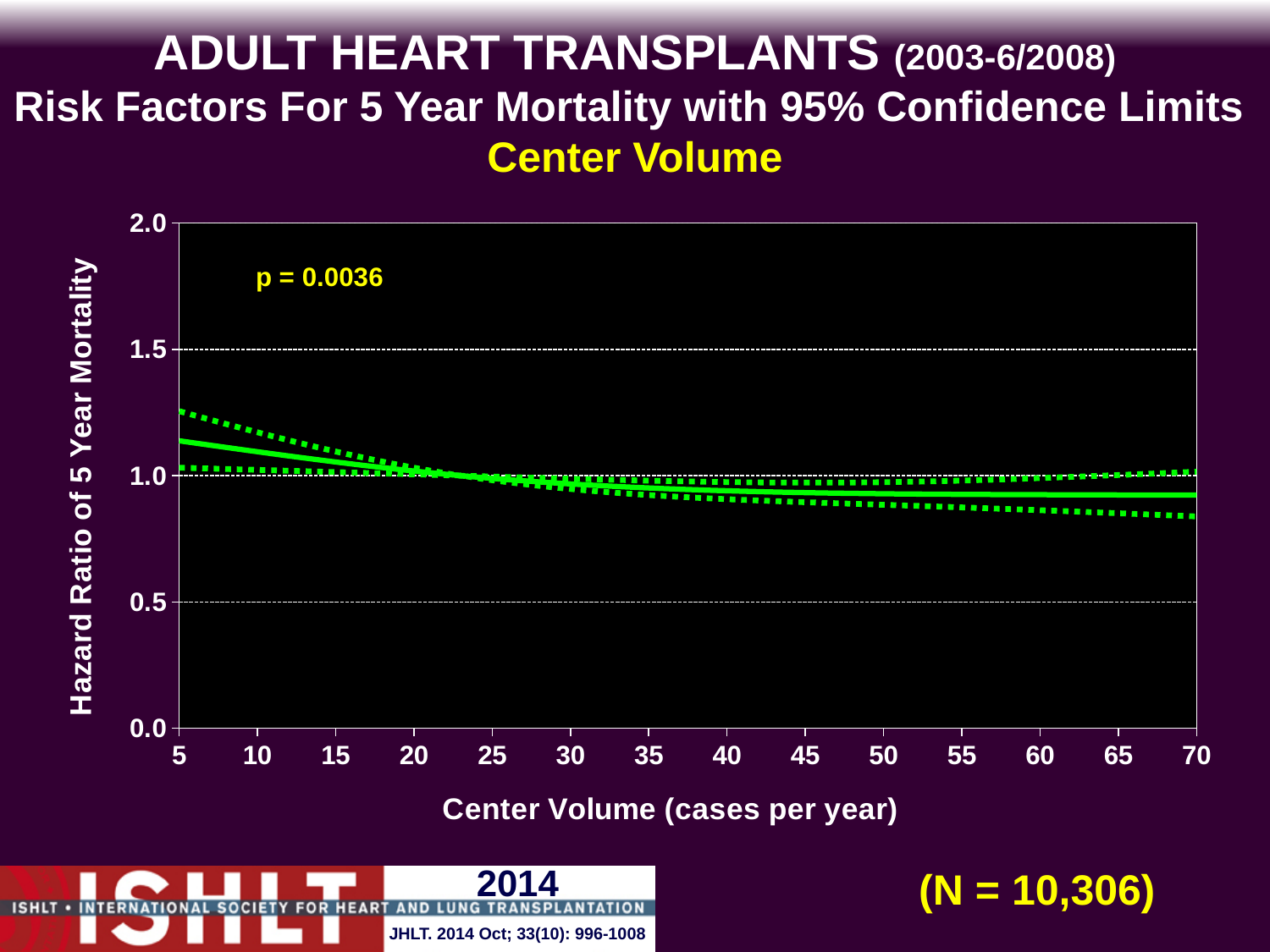
How many tick labels are shown on the x axis (Center Volume)? 14 What is the highest value labelled on the y axis? 2.0 What p-value is printed on the chart? p = 0.0036 What kind of chart is shown on the slide? line chart Does the solid hazard ratio line rise or fall as center volume increases from 5 to 70 cases per year? fall Is the lower confidence limit (lower dotted line) at a center volume of 70 cases per year greater or less than 0.5? greater Is the hazard ratio (solid line) at a center volume of 5 cases per year greater or less than 1.0? greater Is the hazard ratio (solid line) at a center volume of 70 cases per year greater or less than 1.0? less Is the hazard ratio (solid line) higher at a center volume of 5 or at a center volume of 70 cases per year? 5